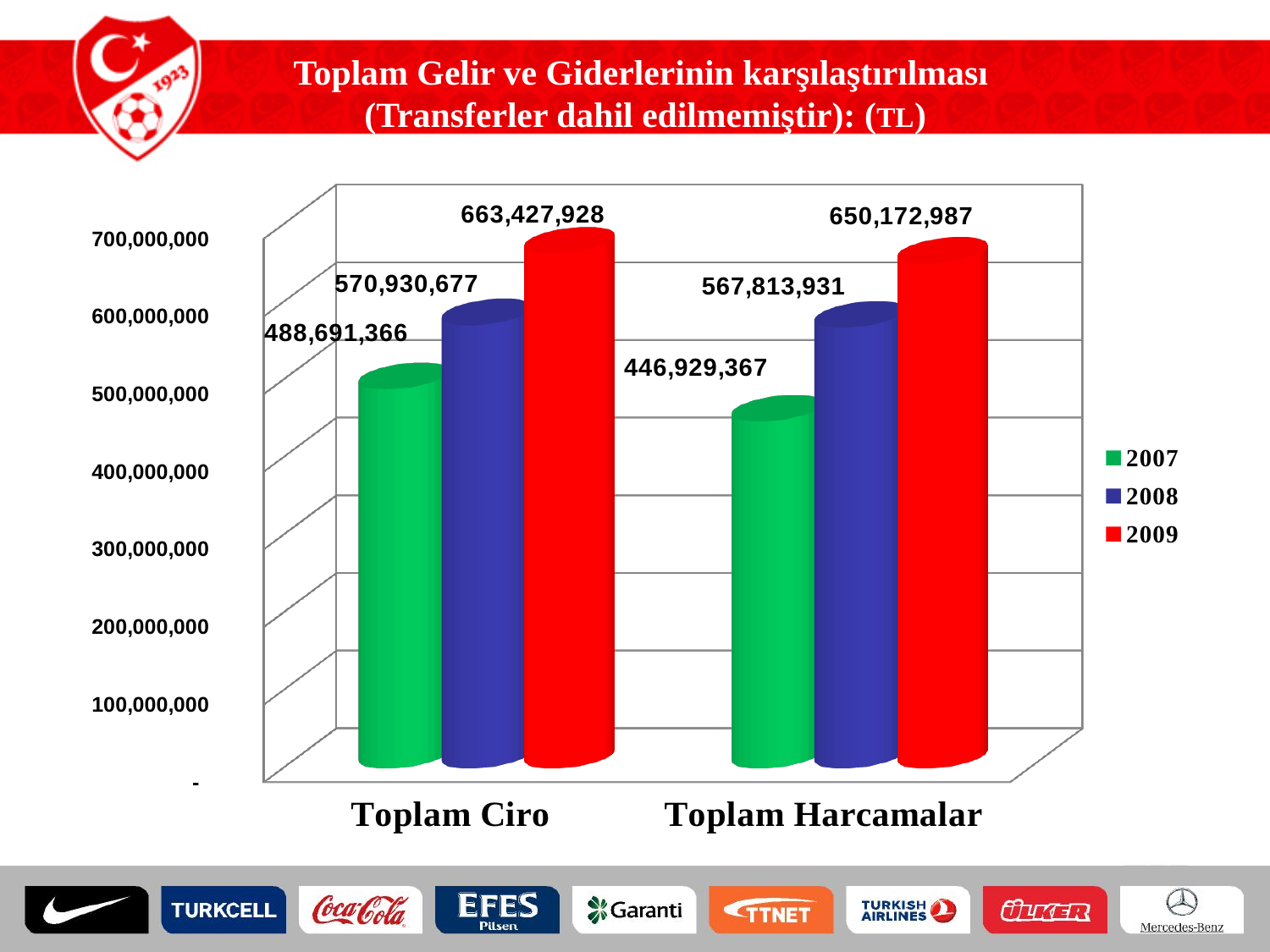
Which year has the lowest value in the Toplam Harcamalar category? 2007 Which is larger: the 2007 value for Toplam Ciro or the 2007 value for Toplam Harcamalar? Toplam Ciro Which year has the highest value in the Toplam Ciro category? 2009 What is the difference between the 2007 values for Toplam Ciro and Toplam Harcamalar? 41,761,999 What is the value for 2009 in the Toplam Harcamalar category? 650,172,987 Which colour represents the year 2008 in the legend? Blue How many series does the legend list? 3 What kind of chart is shown on the slide? Bar chart What is the difference between the 2009 values for Toplam Ciro and Toplam Harcamalar? 13,254,941 What is the value for 2009 in the Toplam Ciro category? 663,427,928 What is the value for 2007 in the Toplam Harcamalar category? 446,929,367 What is the value for 2008 in the Toplam Ciro category? 570,930,677